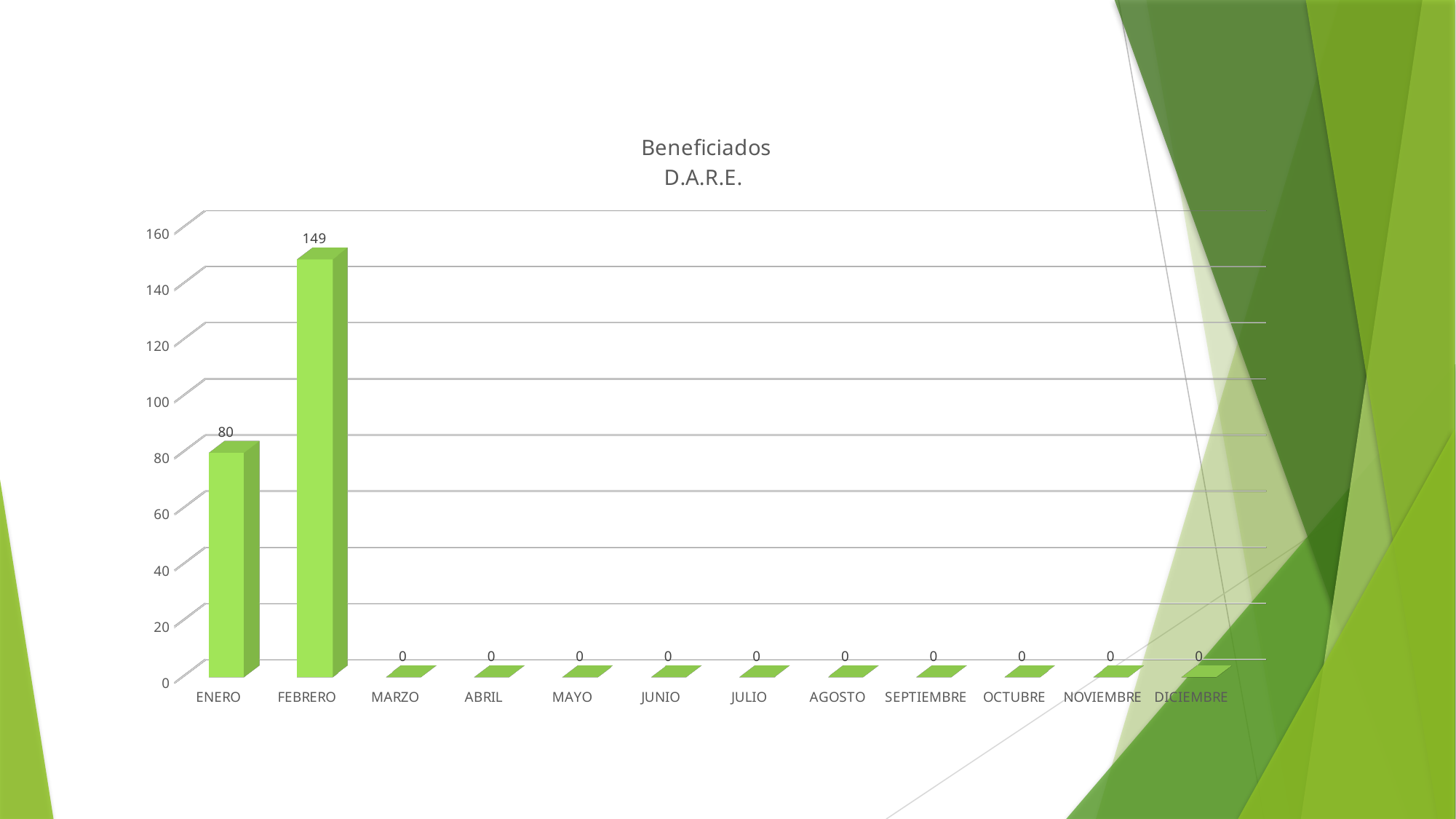
What is the value for DICIEMBRE? 0 Which month has the highest value? FEBRERO How many months have a value of 0? 10 What is the difference between the values for FEBRERO and ENERO? 69 What is the title of the chart? Beneficiados D.A.R.E. Which is larger, the value for ENERO or the value for FEBRERO? FEBRERO What is the value for FEBRERO? 149 How many categories are shown on the x axis? 12 Is the value for FEBRERO greater or less than 140? greater What is the value for MARZO? 0 What kind of chart is shown? bar chart What is the value for ENERO? 80